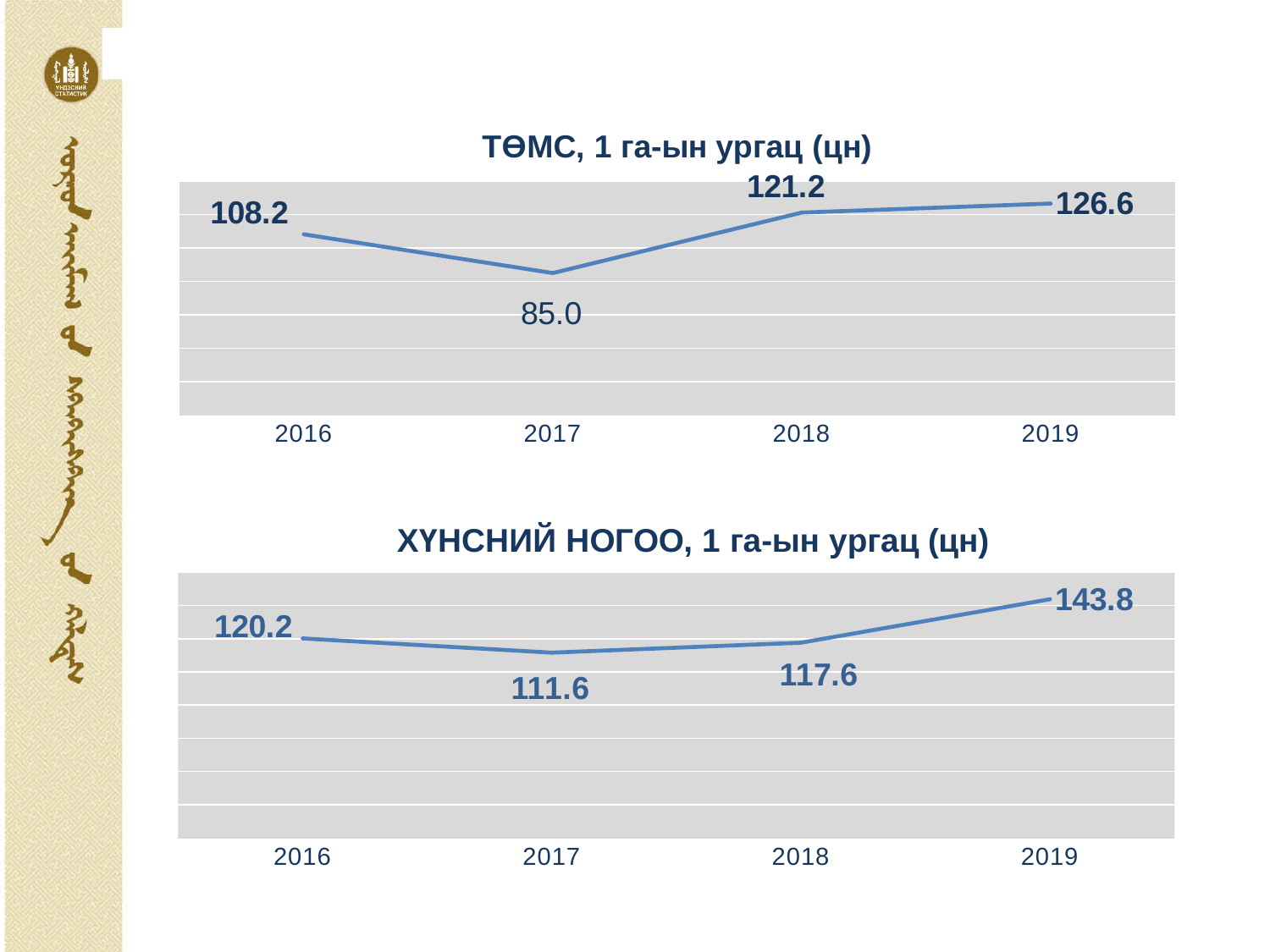
In the bottom chart (ХҮНСНИЙ НОГОО, 1 га-ын ургац (цн)), is the value for 2017 larger or smaller than the value for 2018? Smaller In the top chart (ТӨМС, 1 га-ын ургац (цн)), which year has the lowest value? 2017 In the bottom chart (ХҮНСНИЙ НОГОО, 1 га-ын ургац (цн)), what is the value for 2018? 117.6 In the top chart (ТӨМС, 1 га-ын ургац (цн)), what is the value for 2017? 85.0 In the top chart (ТӨМС, 1 га-ын ургац (цн)), what is the value for 2019? 126.6 In the top chart (ТӨМС, 1 га-ын ургац (цн)), how many years are plotted? 4 In the bottom chart (ХҮНСНИЙ НОГОО, 1 га-ын ургац (цн)), which year has the highest value? 2019 In the bottom chart (ХҮНСНИЙ НОГОО, 1 га-ын ургац (цн)), what is the difference between the 2019 and 2016 values? 23.6 What type of chart is the bottom chart (ХҮНСНИЙ НОГОО, 1 га-ын ургац (цн))? Line chart In the bottom chart (ХҮНСНИЙ НОГОО, 1 га-ын ургац (цн)), what is the value for 2016? 120.2 In the top chart (ТӨМС, 1 га-ын ургац (цн)), what is the difference between the 2018 and 2017 values? 36.2 In the top chart (ТӨМС, 1 га-ын ургац (цн)), which year has the highest value? 2019